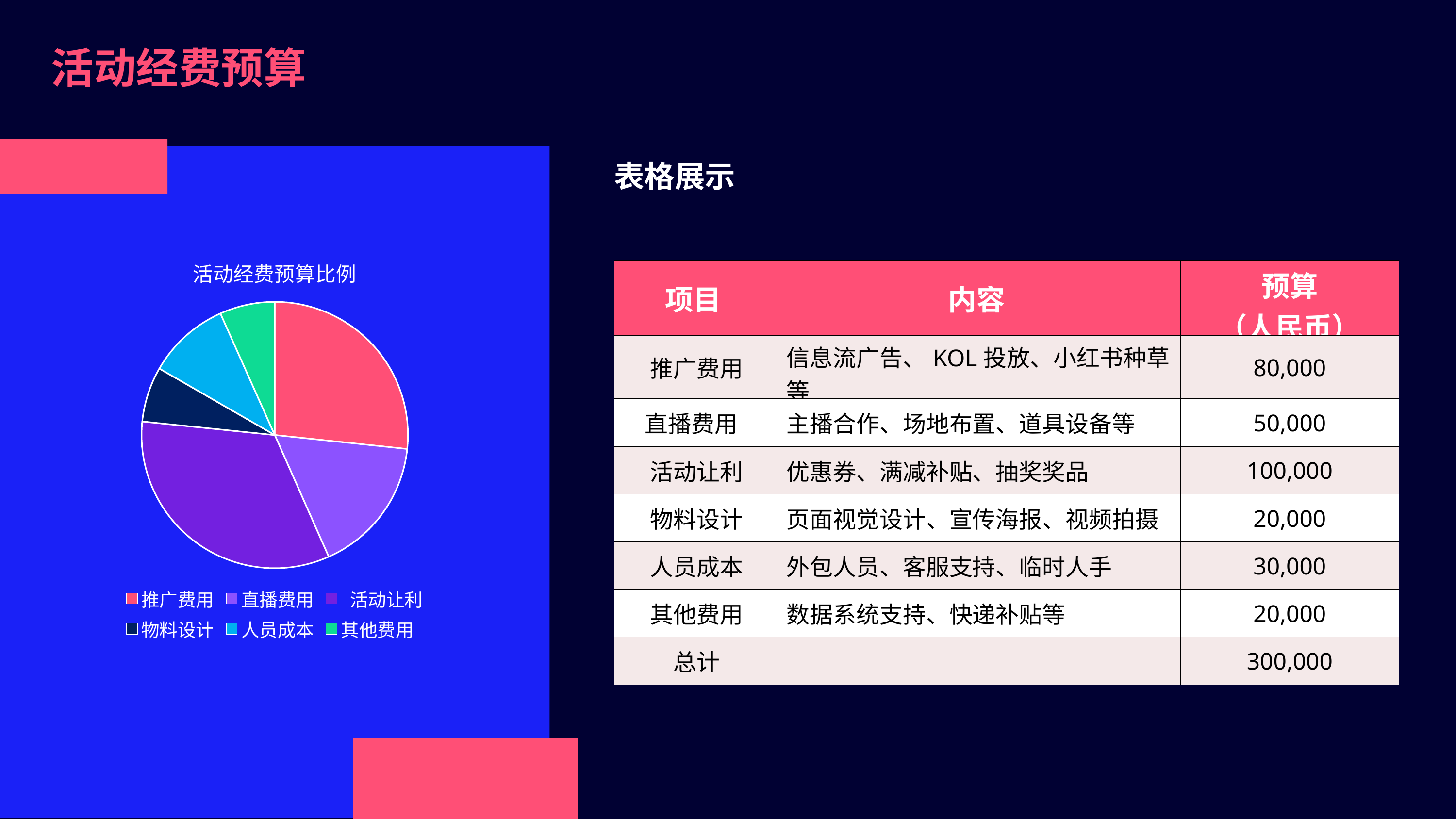
What colour is the 推广费用 slice in the pie chart? red/pink In the pie chart, which slice is larger: 推广费用 or 直播费用? 推广费用 In the pie chart, which slice is larger: 人员成本 or 物料设计? 人员成本 What is the title of the pie chart? 活动经费预算比例 How many categories (slices) does the pie chart have? 6 According to the table, what is the budget for 活动让利? 100,000 Which category has the largest slice in the pie chart? 活动让利 How many entries does the pie chart's legend list? 6 What is the difference between the budgets for 活动让利 and 推广费用 shown in the table? 20,000 What kind of chart is shown on the left of the slide? pie chart According to the table, what is the budget for 直播费用? 50,000 What is the total budget (总计) shown in the table? 300,000